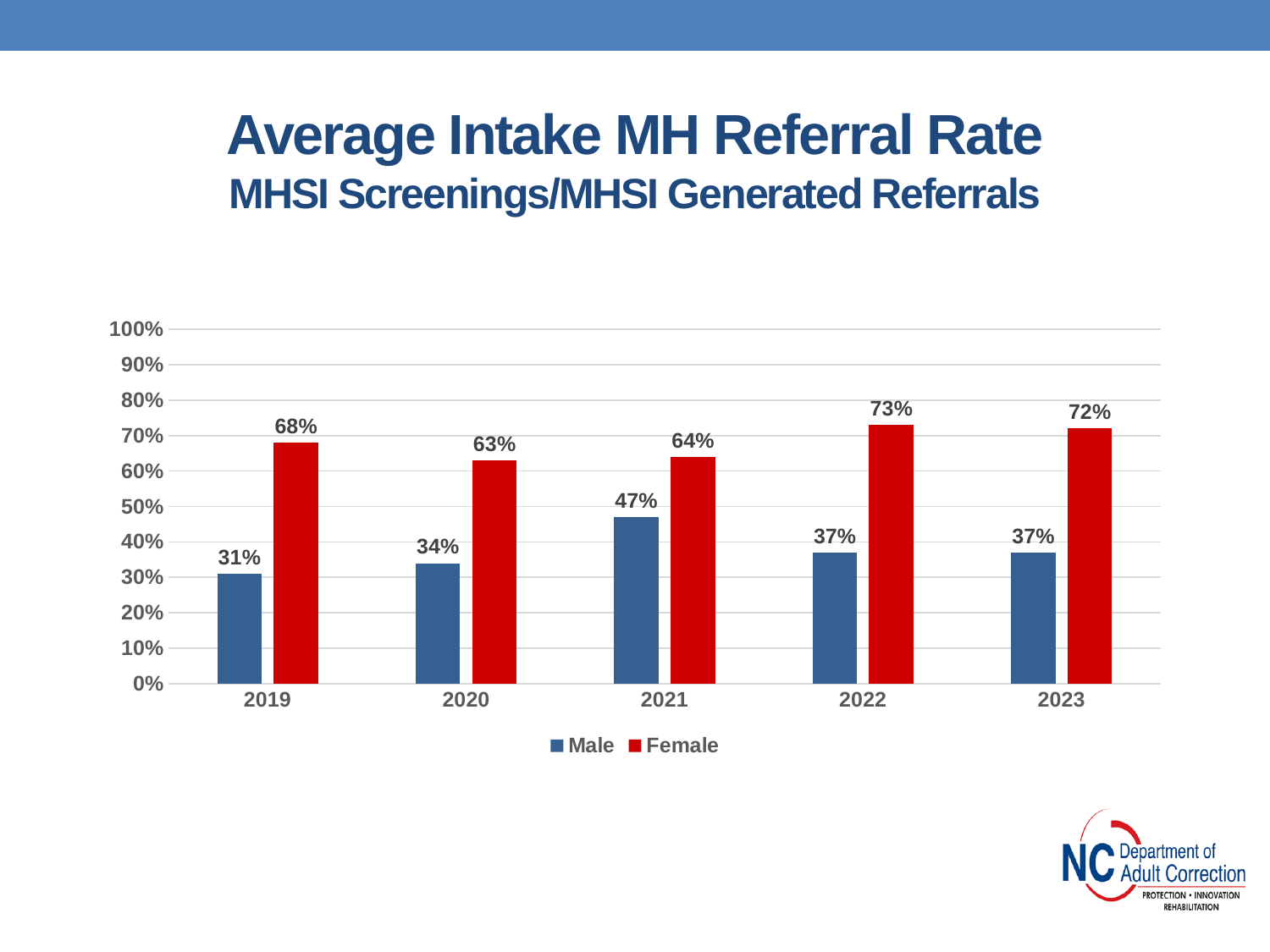
What colour are the Female bars? Red What kind of chart is shown on the slide? Bar chart What is the difference between the Female and Male referral rates in 2020? 29% In which year is the Male referral rate lowest? 2019 Does the Female referral rate rise or fall from 2019 to 2020? Fall Which is larger in 2023, the Male rate or the Female rate? Female What is the Male referral rate in 2019? 31% What is the Male referral rate in 2021? 47% How many series does the legend list? 2 How many years are shown on the x axis? 5 What is the Female referral rate in 2022? 73% In which year is the Female referral rate highest? 2022